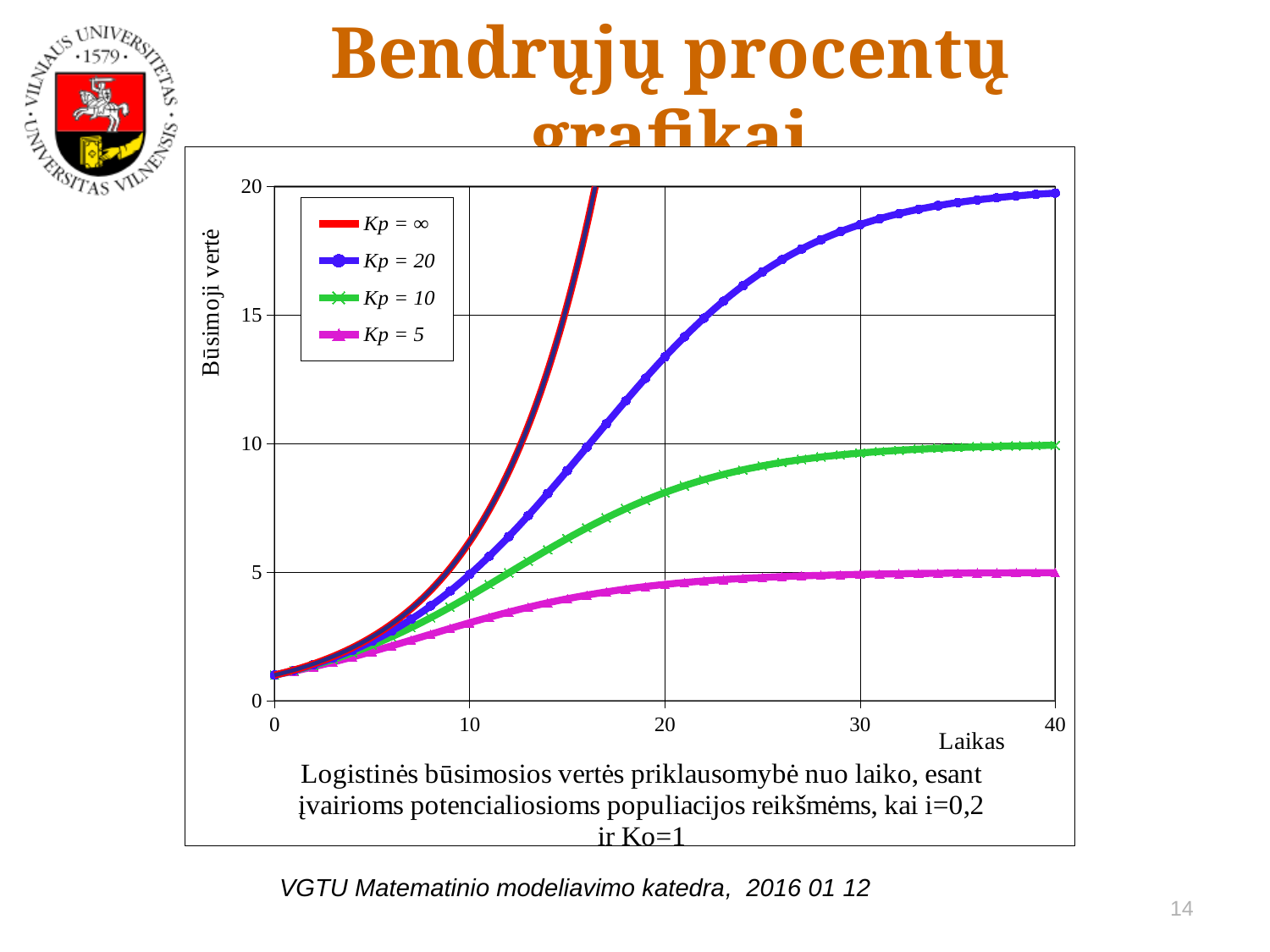
Is the value of the Kp = 20 series at Laikas = 20 greater or less than 10? greater At Laikas = 30, which series has the larger value: Kp = 20 or Kp = 5? Kp = 20 What is the title of the vertical axis of the chart? Būsimoji vertė At Laikas = 40, which of the plotted series has the lowest value? Kp = 5 What is the title of the horizontal axis of the chart? Laikas Is the value of the Kp = 5 series at Laikas = 40 greater or less than 10? less What kind of chart is shown on the slide? line chart Is the value of the Kp = ∞ series at Laikas = 10 greater or less than 5? greater Do the values of the Kp = 20 series rise or fall as Laikas increases? rise How many series does the chart legend list? 4